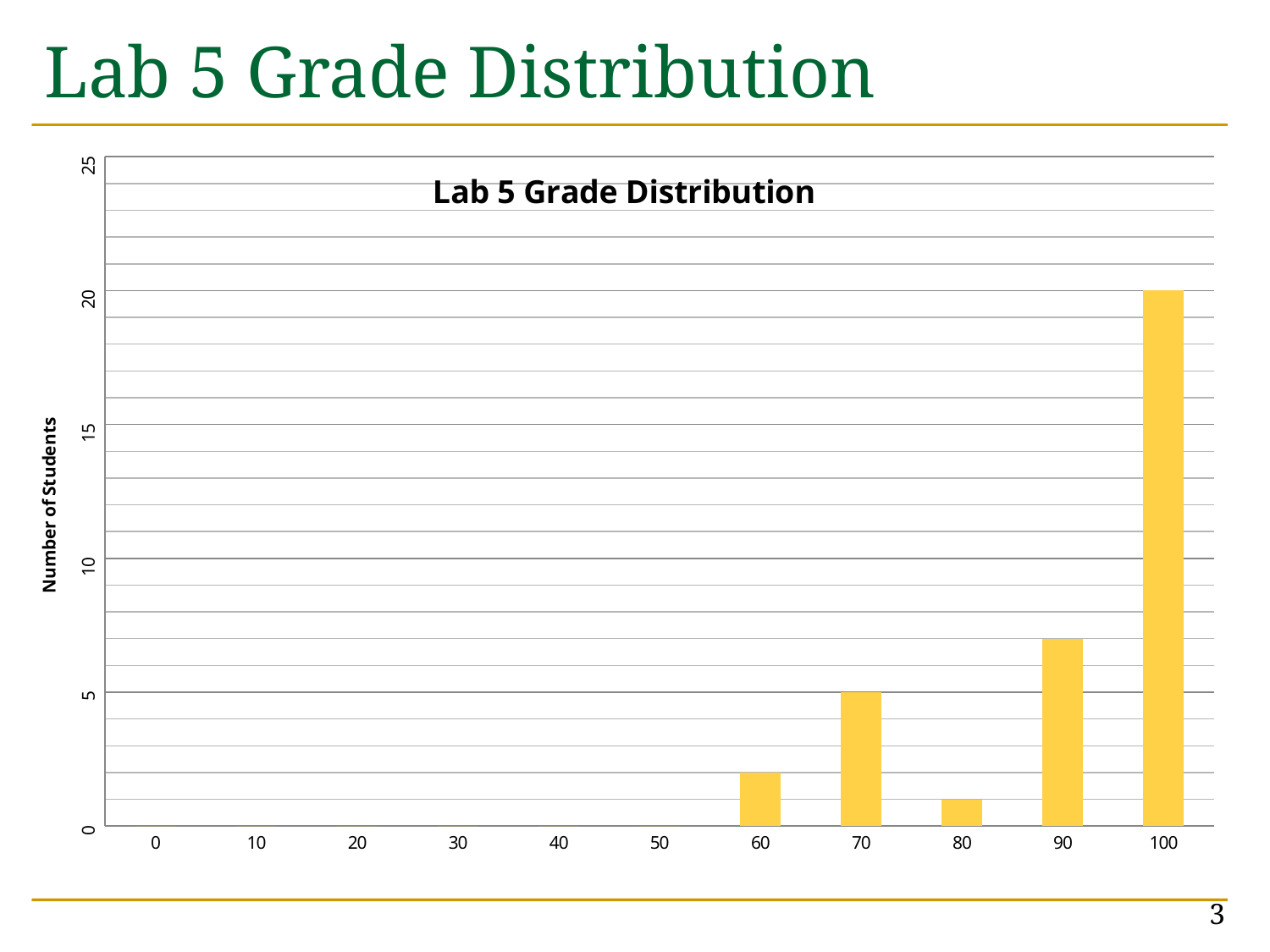
What type of chart is shown on the slide? bar chart What is the difference between the number of students with a grade of 100 and the number with a grade of 70? 15 How many students received a grade of 70? 5 What is the title of the chart? Lab 5 Grade Distribution What is the label on the vertical axis of the chart? Number of Students Which grade has the highest number of students? 100 Is the number of students with a grade of 60 greater or less than 5? less Among the grades with a visible bar, which grade has the fewest students? 80 Which grade has more students, 90 or 70? 90 Is the number of students with a grade of 90 greater or less than 10? less How many grade categories are labelled along the x axis? 11 How many students received a grade of 100? 20